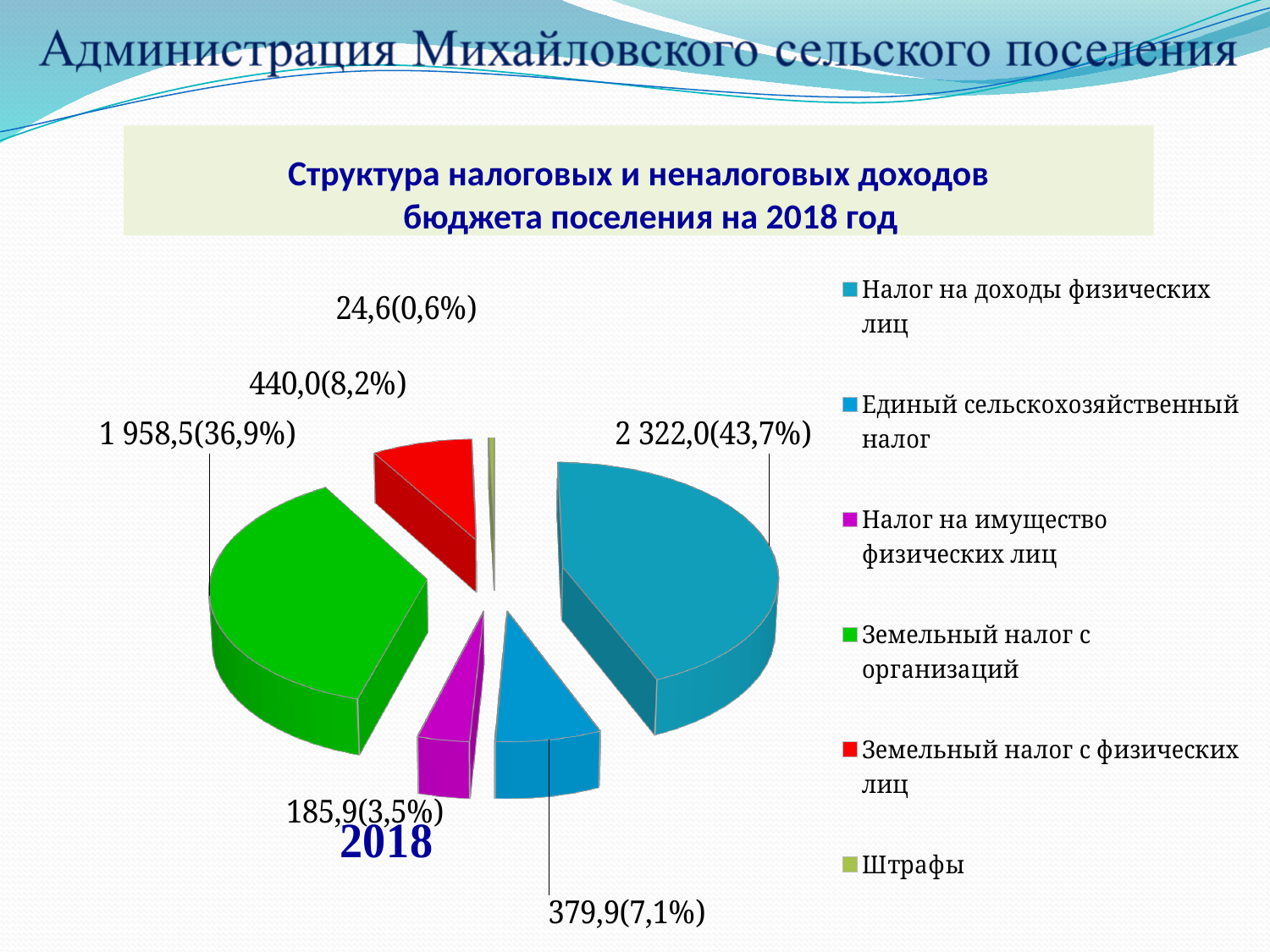
What share of the pie does Земельный налог с физических лиц represent? 8,2% What value is labelled for Штрафы in the pie chart? 24,6(0,6%) Which is larger in the pie chart: Единый сельскохозяйственный налог or Земельный налог с физических лиц? Земельный налог с физических лиц Which category has the smallest slice in the pie chart? Штрафы How many entries does the legend of the pie chart list? 6 What value is labelled for Налог на доходы физических лиц in the pie chart? 2 322,0(43,7%) Which category has the largest slice in the pie chart? Налог на доходы физических лиц What value is labelled for Земельный налог с организаций in the pie chart? 1 958,5(36,9%) What share of the pie does Налог на имущество физических лиц represent? 3,5% What value is labelled for Единый сельскохозяйственный налог in the pie chart? 379,9(7,1%) How many slices does the pie chart have? 6 What kind of chart is shown on the slide? pie chart